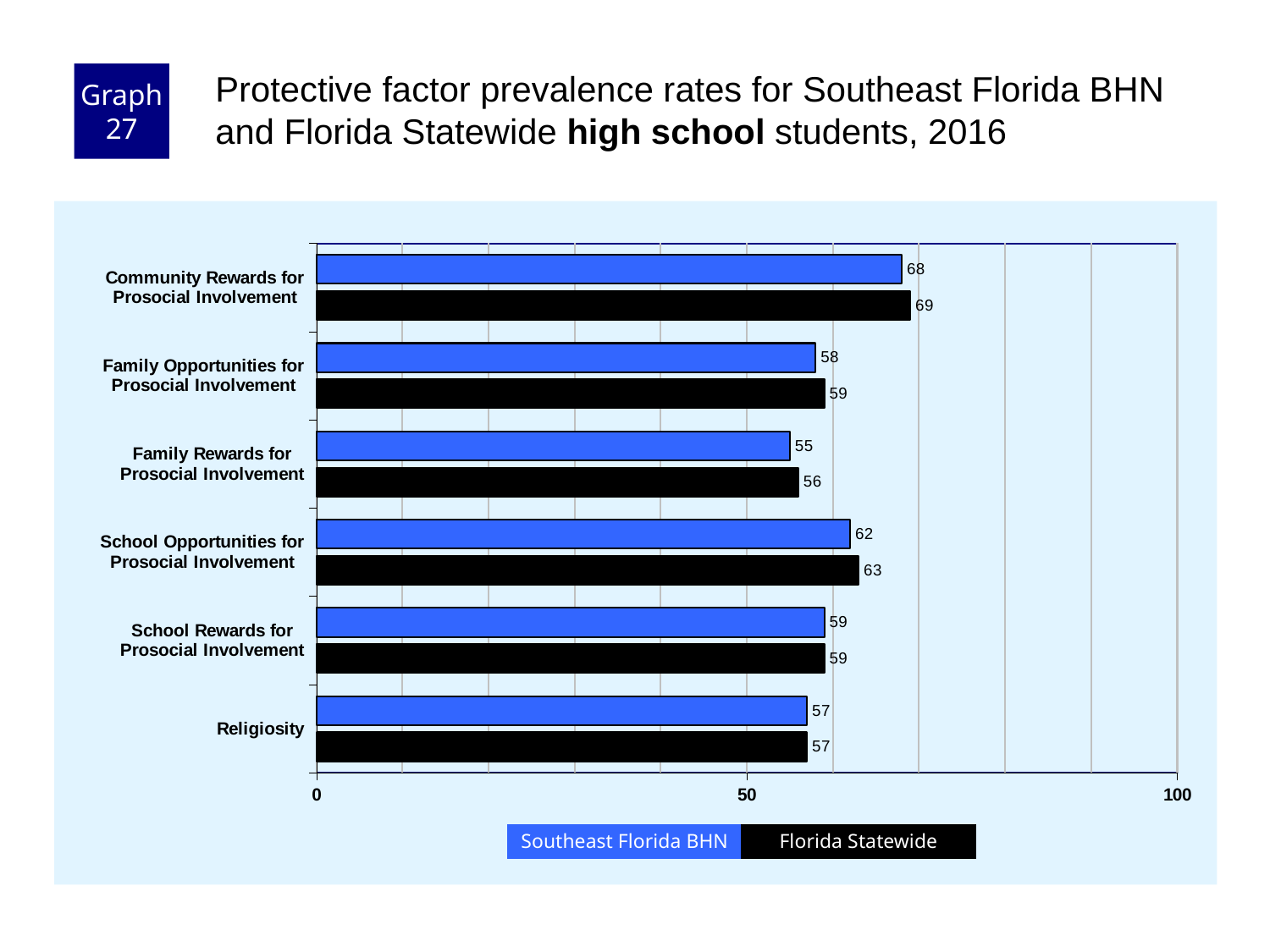
Which is larger for Family Rewards for Prosocial Involvement: the Southeast Florida BHN value or the Florida Statewide value? Florida Statewide Which category has the highest Florida Statewide value? Community Rewards for Prosocial Involvement Which colour represents Florida Statewide in the chart? Black Which category has the lowest Southeast Florida BHN value? Family Rewards for Prosocial Involvement How many series does the legend list? 2 Is the Southeast Florida BHN value for School Rewards for Prosocial Involvement greater or less than 50? greater What is the Southeast Florida BHN value for Community Rewards for Prosocial Involvement? 68 What is the Florida Statewide value for Family Opportunities for Prosocial Involvement? 59 What is the difference between the Florida Statewide and Southeast Florida BHN values for School Opportunities for Prosocial Involvement? 1 What is the Southeast Florida BHN value for Religiosity? 57 What kind of chart is shown on the slide? Bar chart How many protective factor categories are shown on the chart? 6